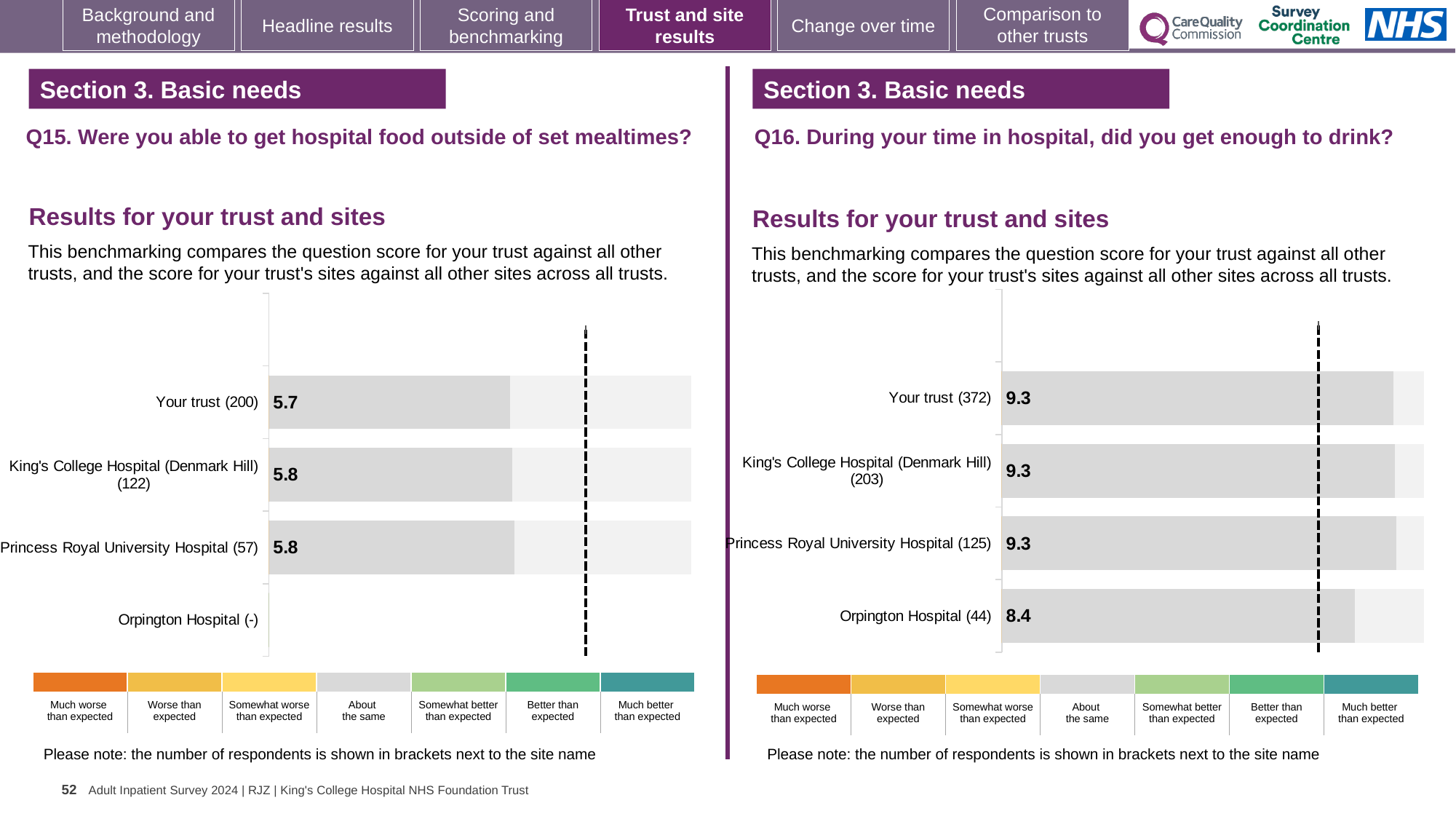
On the Q16 chart (right), what is the score for Orpington Hospital? 8.4 On the Q16 chart (right), which site has the lowest score? Orpington Hospital On the Q16 chart (right), how many respondents are shown in brackets for Orpington Hospital? 44 On the Q16 chart (right), what is the score for King's College Hospital (Denmark Hill)? 9.3 On the Q16 chart (right), which is larger: the score for Princess Royal University Hospital or the score for Orpington Hospital? Princess Royal University Hospital On the Q15 chart (left), which row has the lowest printed score? Your trust On the Q15 chart (left), what is the score for Your trust? 5.7 On the Q15 chart (left), how many respondents are shown in brackets for Your trust? 200 What kind of chart is the Q16 chart (right)? Bar chart On the Q16 chart (right), what is the difference between the score for Your trust and the score for Orpington Hospital? 0.9 On the Q15 chart (left), what is the score for Princess Royal University Hospital? 5.8 How many sites or rows are listed on the Q15 chart (left)? 4